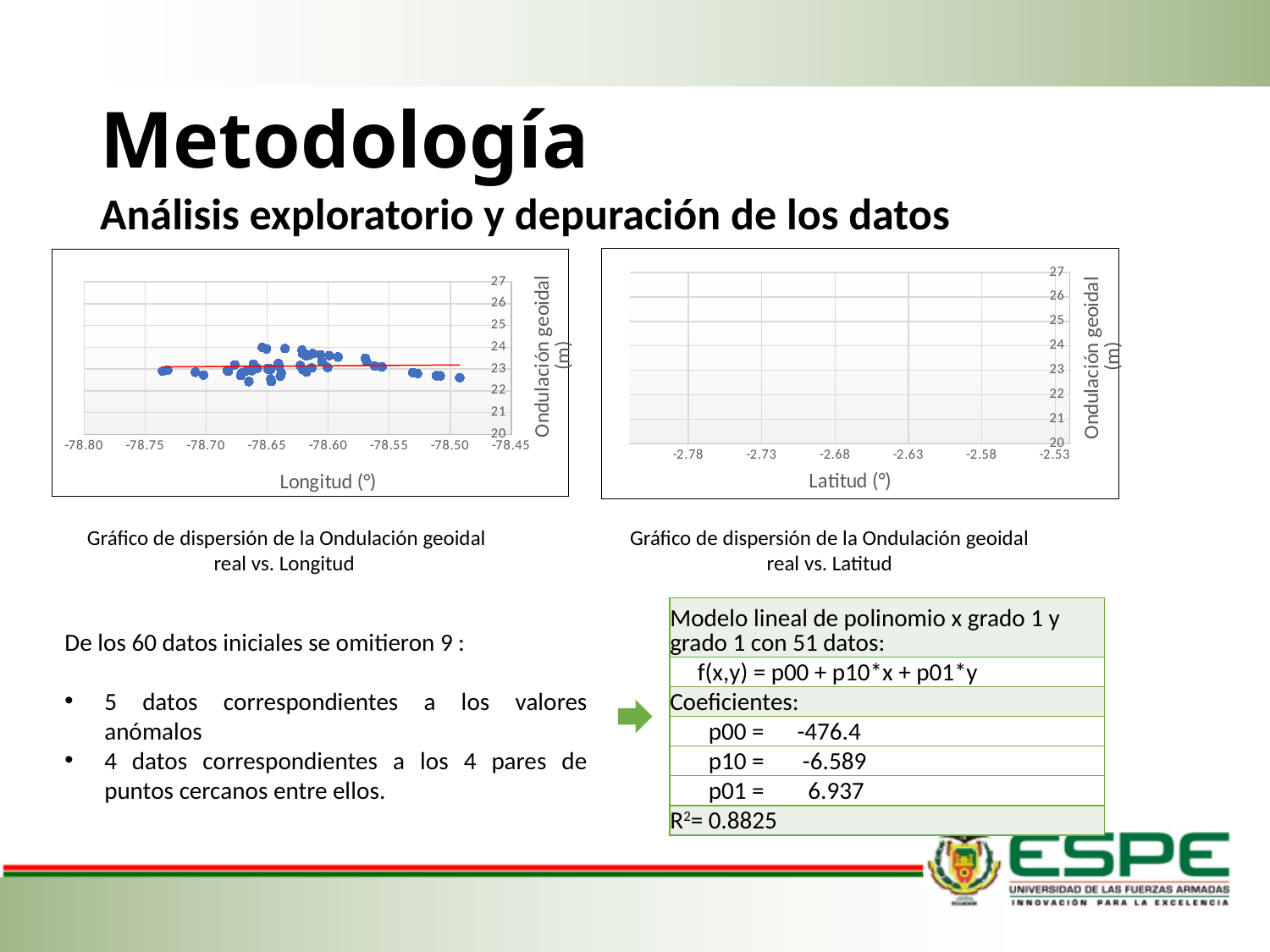
On the left chart, what is the highest value shown on the y axis? 27 On the left chart, are the plotted points greater or less than 25 on the y axis? less On the right chart, what is the leftmost tick label on the x axis? -2.78 On the left chart, what is the leftmost tick label on the x axis? -78.80 On the left chart, are the plotted points greater or less than 21 on the y axis? greater What is the x-axis label of the right chart? Latitud (°) What is the x-axis label of the left chart? Longitud (°) What kind of chart is the left chart (Ondulación geoidal real vs. Longitud)? scatter chart On the right chart, what is the rightmost tick label on the x axis? -2.53 On the left chart, what is the lowest value shown on the y axis? 20 What is the y-axis label of the right chart? Ondulación geoidal (m)